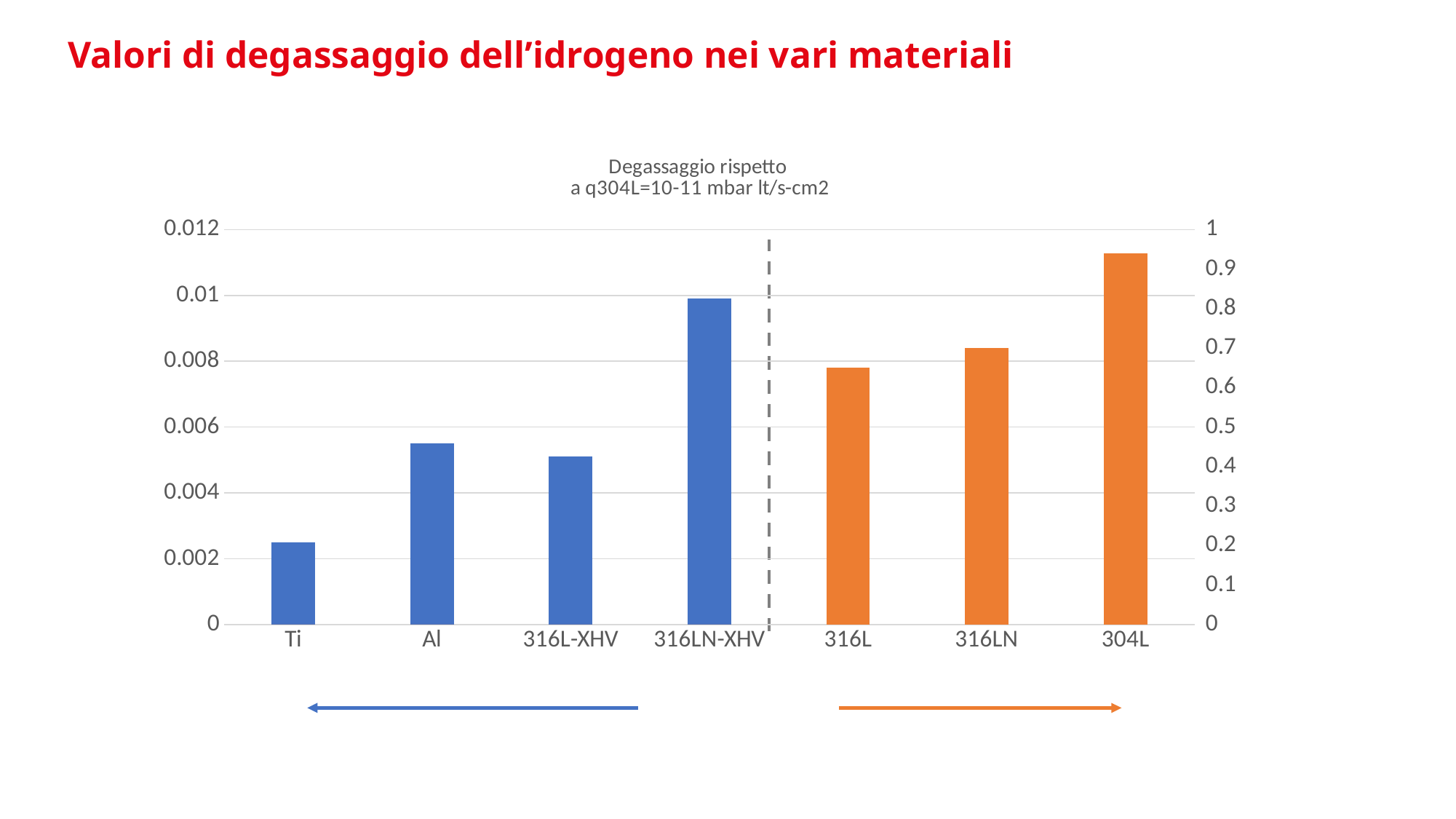
On the left axis, is the value for Al greater or less than 0.004? greater Which bar is taller, Ti or 316LN-XHV? 316LN-XHV On the left axis, is the value for Ti greater or less than 0.004? less On the left axis, is the value for 316LN-XHV greater or less than 0.008? greater Which of the blue bars (Ti, Al, 316L-XHV, 316LN-XHV) is the lowest? Ti What kind of chart is shown on the slide? bar chart Which of the blue bars (Ti, Al, 316L-XHV, 316LN-XHV) is the highest? 316LN-XHV What is the title printed above the chart? Degassaggio rispetto a q304L=10-11 mbar lt/s-cm2 Which of the orange bars (316L, 316LN, 304L) is the highest? 304L How many materials (categories) are plotted on the x axis? 7